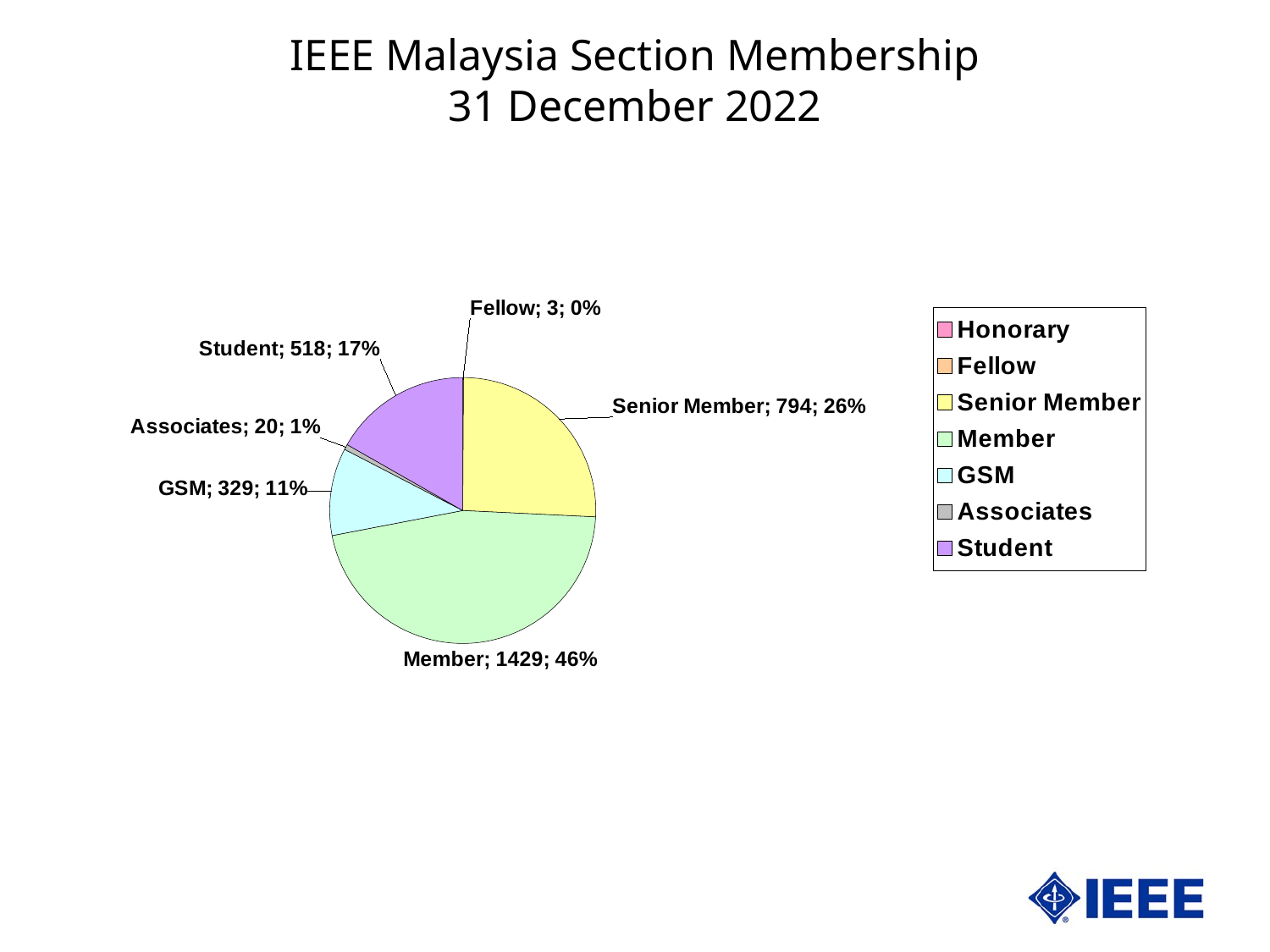
Which category has the largest slice of the pie? Member What share of the pie does GSM represent? 11% How many members are in the Member category? 1429 What share of the pie does the Student category represent? 17% How many Fellows are shown? 3 What is the title of the chart? IEEE Malaysia Section Membership 31 December 2022 Which is larger, the Student count or the GSM count? Student How many entries does the legend list? 7 Which labelled category has the smallest count? Fellow How many Senior Members are shown? 794 What kind of chart is shown on the slide? Pie chart What is the difference between the Member count and the Senior Member count? 635